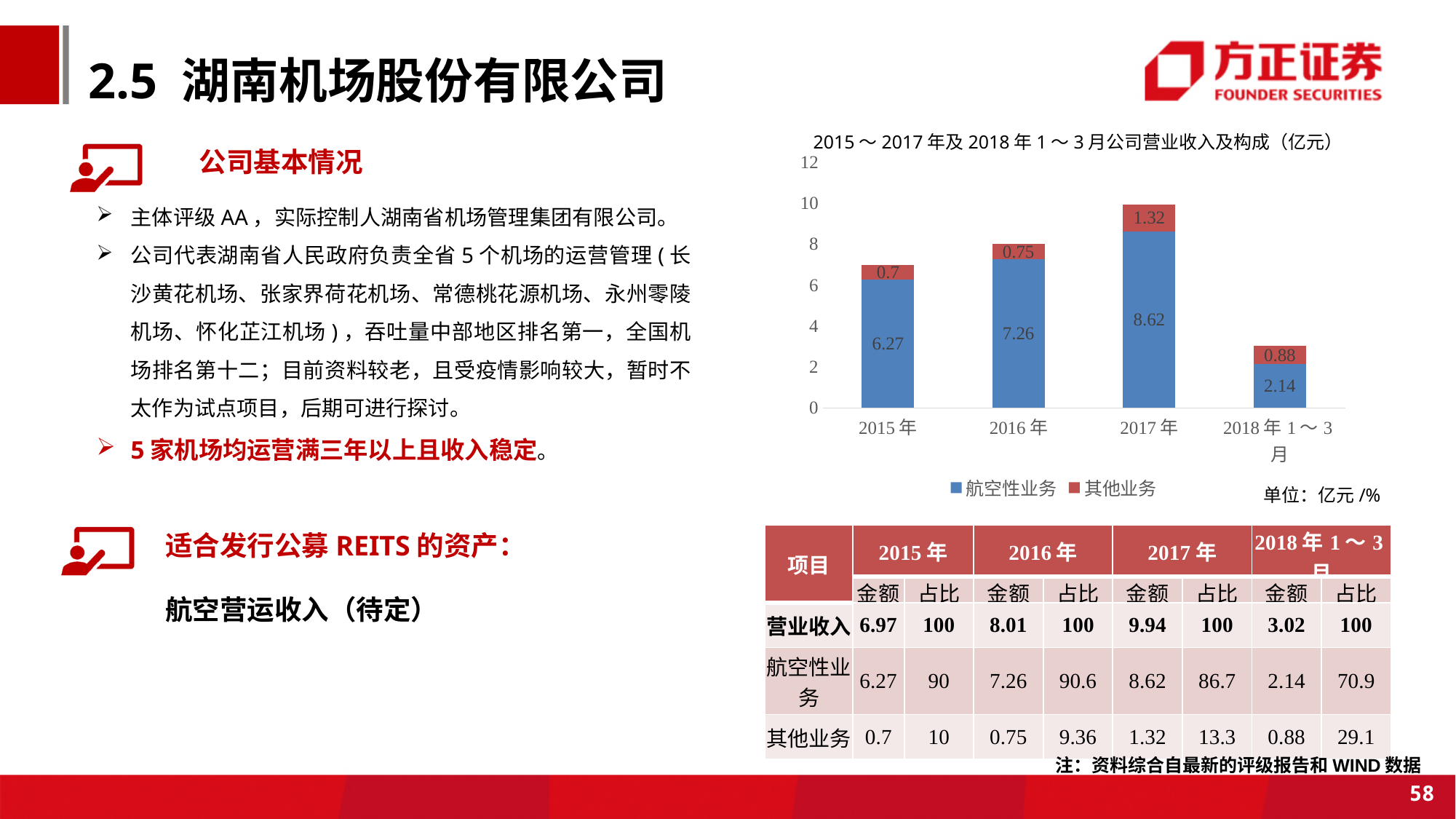
Which category has the highest value for 航空性业务? 2017年 What kind of chart is shown on the slide? Stacked bar chart How many categories are shown on the x axis? 4 What is the total of the stacked bar for 2018年1～3月? 3.02 Which category has the lowest value for 其他业务? 2015年 What is the value of 航空性业务 for 2015年? 6.27 What is the value of 其他业务 for 2018年1～3月? 0.88 What is the total of the stacked bar for 2016年? 8.01 How many series does the legend list? 2 What is the value of 航空性业务 for 2017年? 8.62 Which is larger, the 其他业务 value for 2017年 or for 2016年? 2017年 What is the difference between the 航空性业务 values for 2017年 and 2016年? 1.36